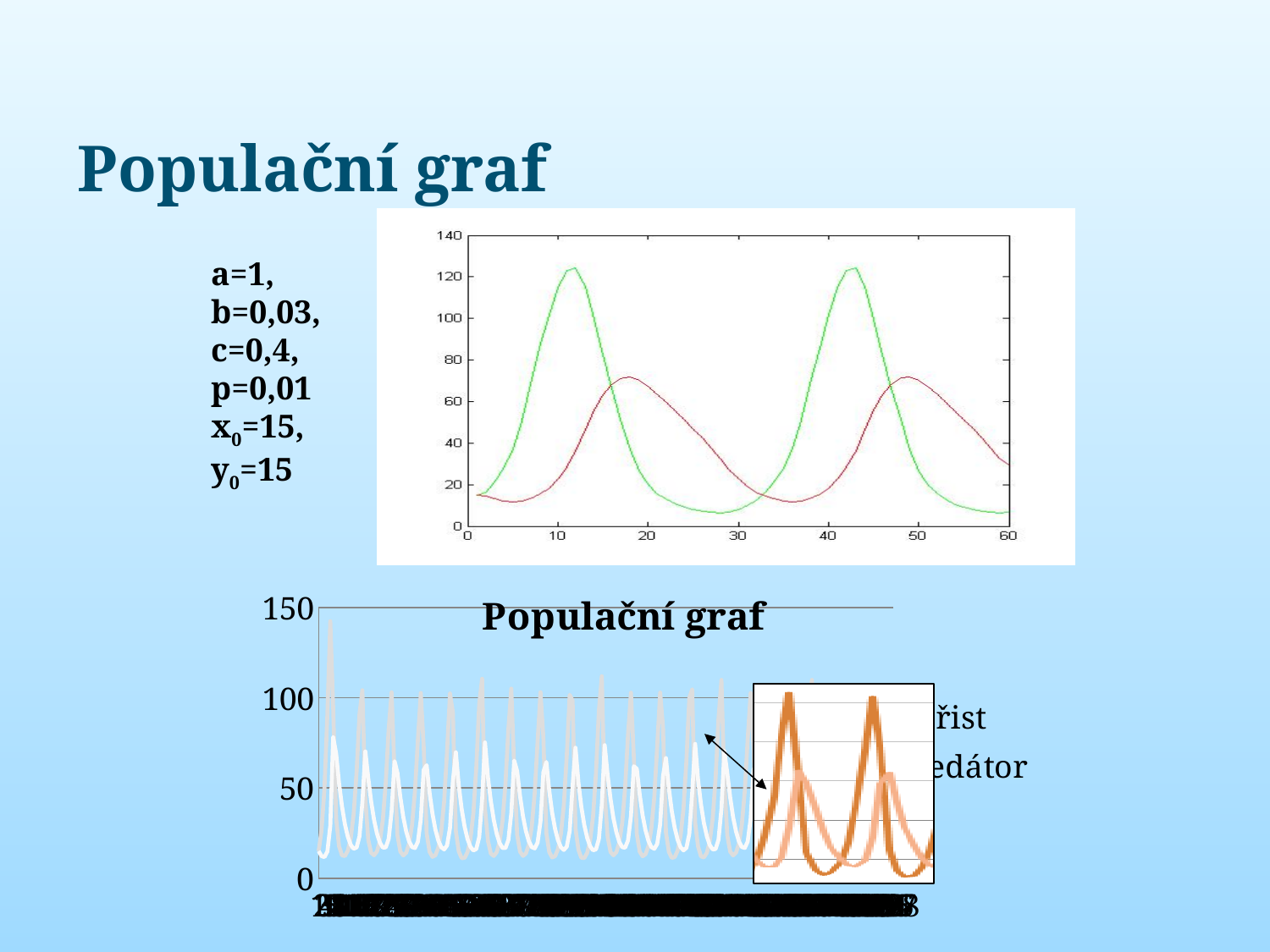
In the top chart, how many lines are plotted? 2 In the top chart, is the peak value of the red line greater or less than 60? greater In the top chart, is the peak value of the red line greater or less than 80? less In the top chart, which line reaches a higher peak, the green line or the red line? green In the bottom chart 'Populační graf', is the first peak of the light grey line greater or less than 100? greater What kind of chart is the top chart on the slide? line chart In the top chart, what is the highest value shown on the y axis? 140 In the bottom chart 'Populační graf', which series reaches higher values, the light grey line or the white line? light grey What is the title of the bottom chart? Populační graf What kind of chart is the bottom chart titled 'Populační graf'? line chart